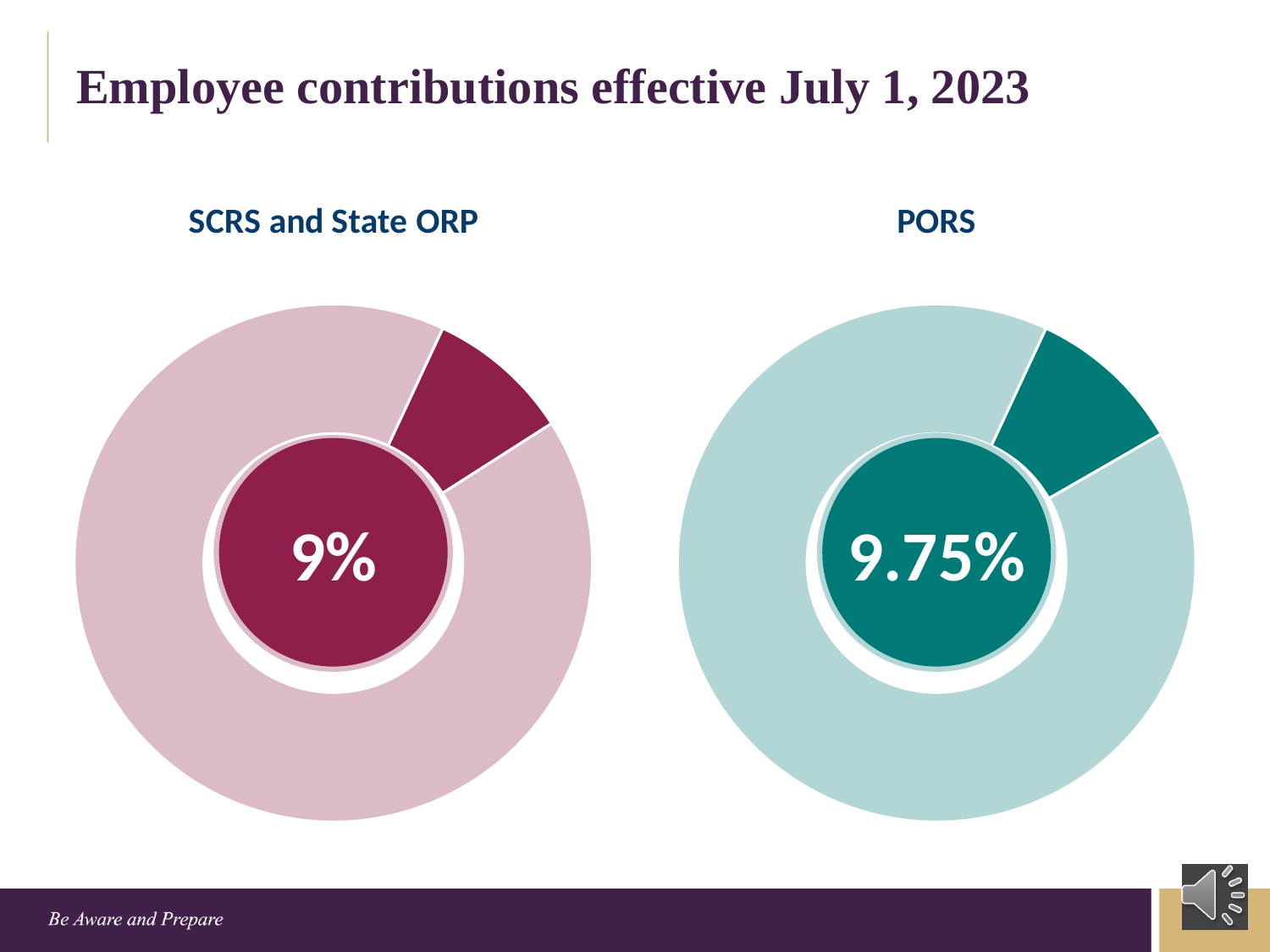
What value is shown in the centre of the PORS chart? 9.75% Which chart shows the higher employee contribution rate, SCRS and State ORP or PORS? PORS How many charts are shown on the slide? 2 In the SCRS and State ORP chart, is the highlighted slice larger or smaller than the remaining slice? Smaller What is the title of the slide containing the two charts? Employee contributions effective July 1, 2023 What kind of chart is used for SCRS and State ORP? Doughnut chart What colour is the highlighted slice in the PORS chart? Teal How many slices does the SCRS and State ORP chart have? 2 How many slices does the PORS chart have? 2 What value is shown in the centre of the SCRS and State ORP chart? 9% What is the difference between the PORS rate and the SCRS and State ORP rate? 0.75%